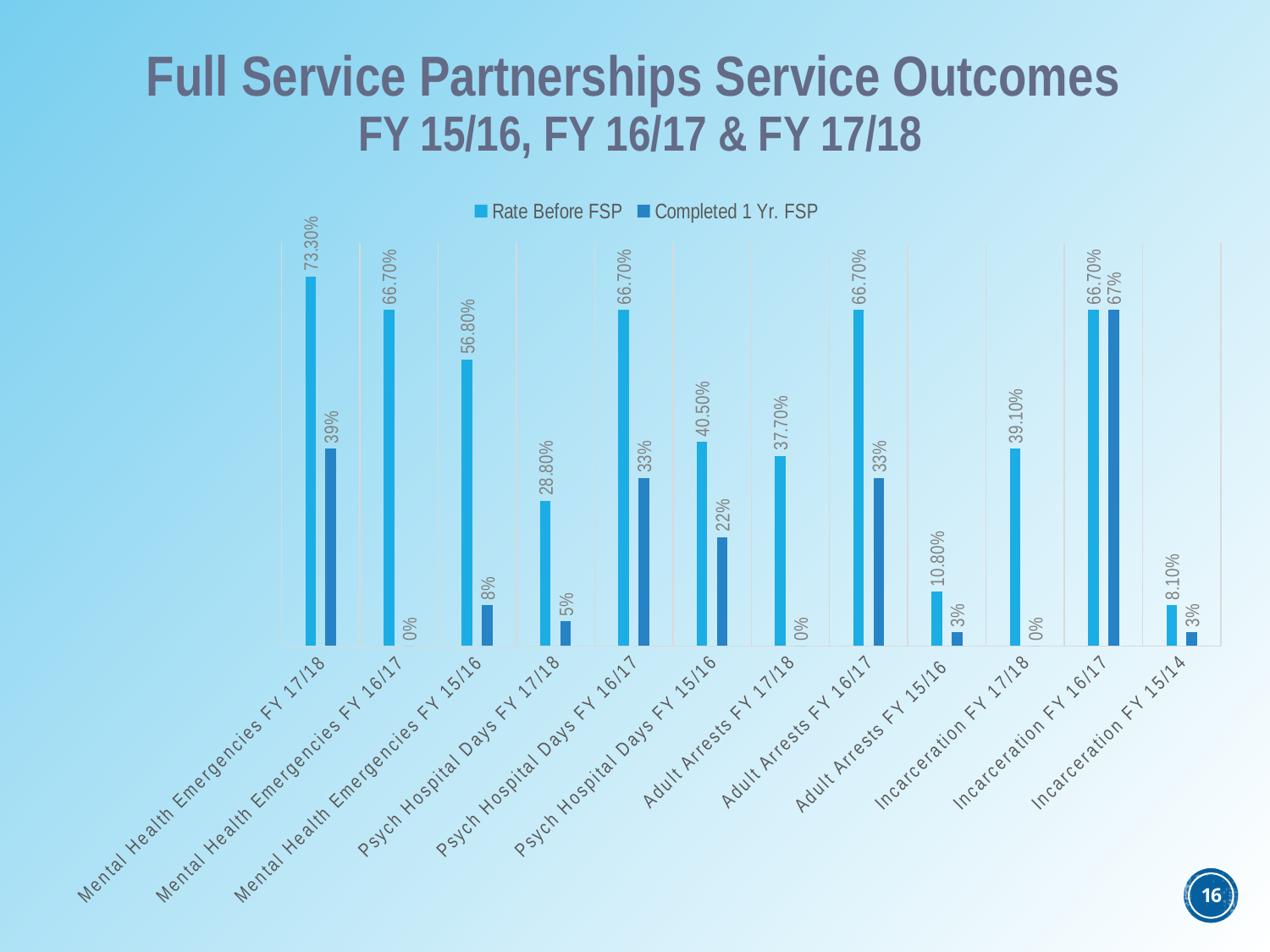
Which category has the highest Rate Before FSP value? Mental Health Emergencies FY 17/18 What is the Completed 1 Yr. FSP value for Psych Hospital Days FY 15/16? 22% How many series does the legend list? 2 What is the Completed 1 Yr. FSP value for Incarceration FY 16/17? 67% What are the two series named in the legend? Rate Before FSP and Completed 1 Yr. FSP What is the difference between the Rate Before FSP and Completed 1 Yr. FSP values for Psych Hospital Days FY 16/17? 33.40% What kind of chart is shown on the slide? Bar chart What is the Rate Before FSP value for Adult Arrests FY 15/16? 10.80% What is the Rate Before FSP value for Mental Health Emergencies FY 17/18? 73.30% Which category has the lowest Rate Before FSP value? Incarceration FY 15/14 Which is larger: the Rate Before FSP value for Psych Hospital Days FY 15/16 or for Adult Arrests FY 17/18? Psych Hospital Days FY 15/16 How many categories are shown on the x axis? 12